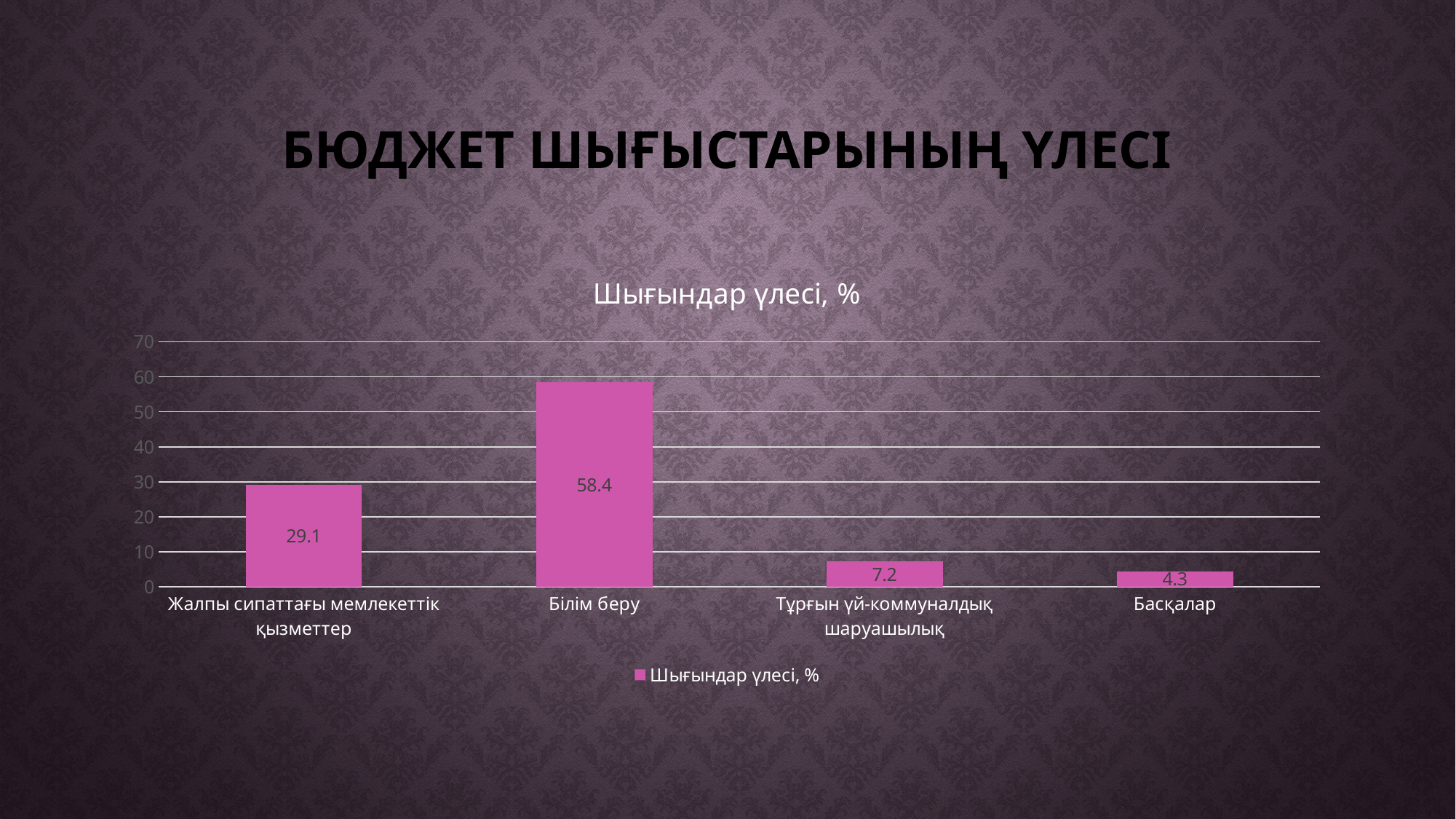
What is the value for Жалпы сипаттағы мемлекеттік қызметтер? 29.1 Which is larger, the value for Тұрғын үй-коммуналдық шаруашылық or the value for Басқалар? Тұрғын үй-коммуналдық шаруашылық Which category has the highest value? Білім беру What is the value for Білім беру? 58.4 What is the difference between the values for Білім беру and Жалпы сипаттағы мемлекеттік қызметтер? 29.3 Which category has the lowest value? Басқалар Is the value for Білім беру greater or less than 50? greater What is the title of the chart? Шығындар үлесі, % What is the value for Тұрғын үй-коммуналдық шаруашылық? 7.2 How many categories are shown on the x axis? 4 What is the value for Басқалар? 4.3 What kind of chart is shown on the slide? bar chart